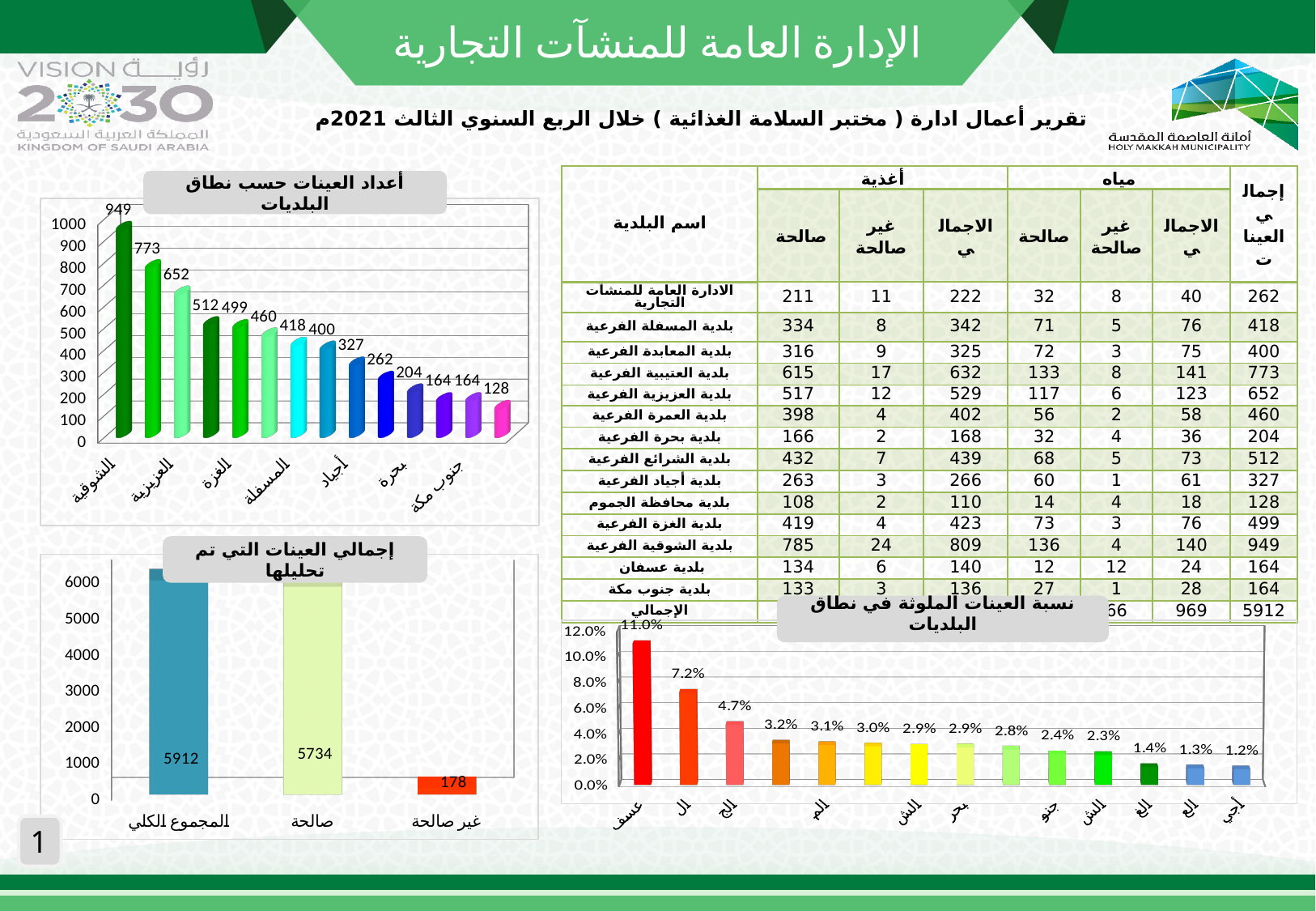
In the chart titled 'نسبة العينات الملوثة في نطاق البلديات', what is the highest value shown? 11.0% In the chart titled 'إجمالي العينات التي تم تحليلها', what is the value for صالحة? 5734 In the chart titled 'أعداد العينات حسب نطاق البلديات', what is the difference between the values for الشوقية and العزيزية? 297 In the chart titled 'أعداد العينات حسب نطاق البلديات', how many bars are plotted? 14 What kind of chart is the chart titled 'نسبة العينات الملوثة في نطاق البلديات'? bar chart In the chart titled 'أعداد العينات حسب نطاق البلديات', do the values rise or fall from left to right? fall In the chart titled 'أعداد العينات حسب نطاق البلديات', which category has the highest value? الشوقية In the chart titled 'أعداد العينات حسب نطاق البلديات', what is the value for أجياد? 327 In the chart titled 'إجمالي العينات التي تم تحليلها', what is the value for غير صالحة? 178 In the chart titled 'أعداد العينات حسب نطاق البلديات', what is the value for العزيزية? 652 In the chart titled 'إجمالي العينات التي تم تحليلها', which is larger, صالحة or غير صالحة? صالحة In the chart titled 'أعداد العينات حسب نطاق البلديات', what is the value for الشوقية? 949